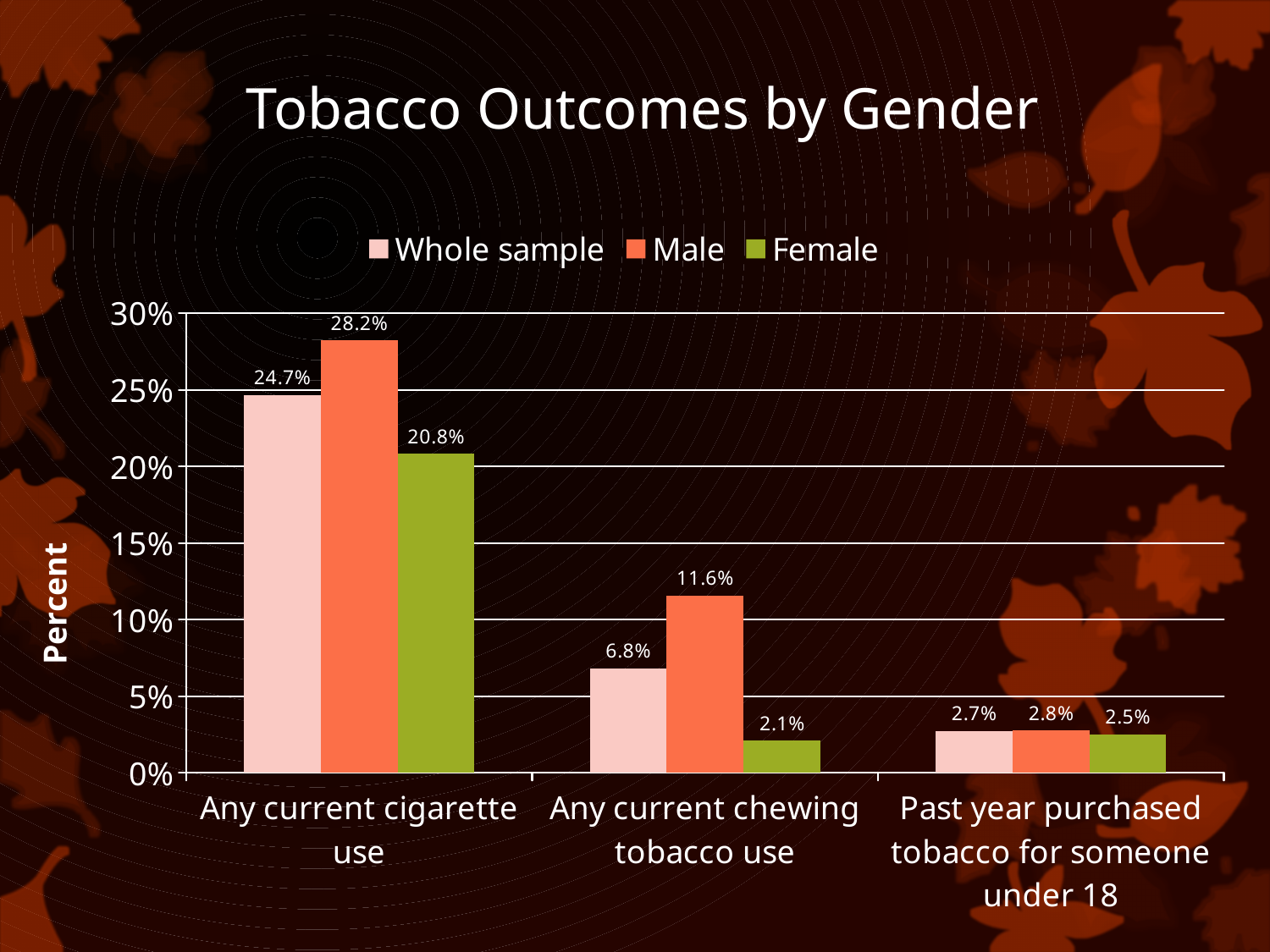
What is the label on the vertical axis? Percent What is the Whole sample value for Past year purchased tobacco for someone under 18? 2.7% What is the Female value for Any current chewing tobacco use? 2.1% What is the Male value for Any current cigarette use? 28.2% What is the difference between the Male and Female values for Any current cigarette use? 7.4% How many categories are shown on the x axis? 3 What is the title of the chart? Tobacco Outcomes by Gender Which category has the highest Female value? Any current cigarette use How many series does the legend list? 3 Which is larger for Any current chewing tobacco use, the Male value or the Whole sample value? Male What kind of chart is shown on the slide? Bar chart Which category has the lowest Male value? Past year purchased tobacco for someone under 18